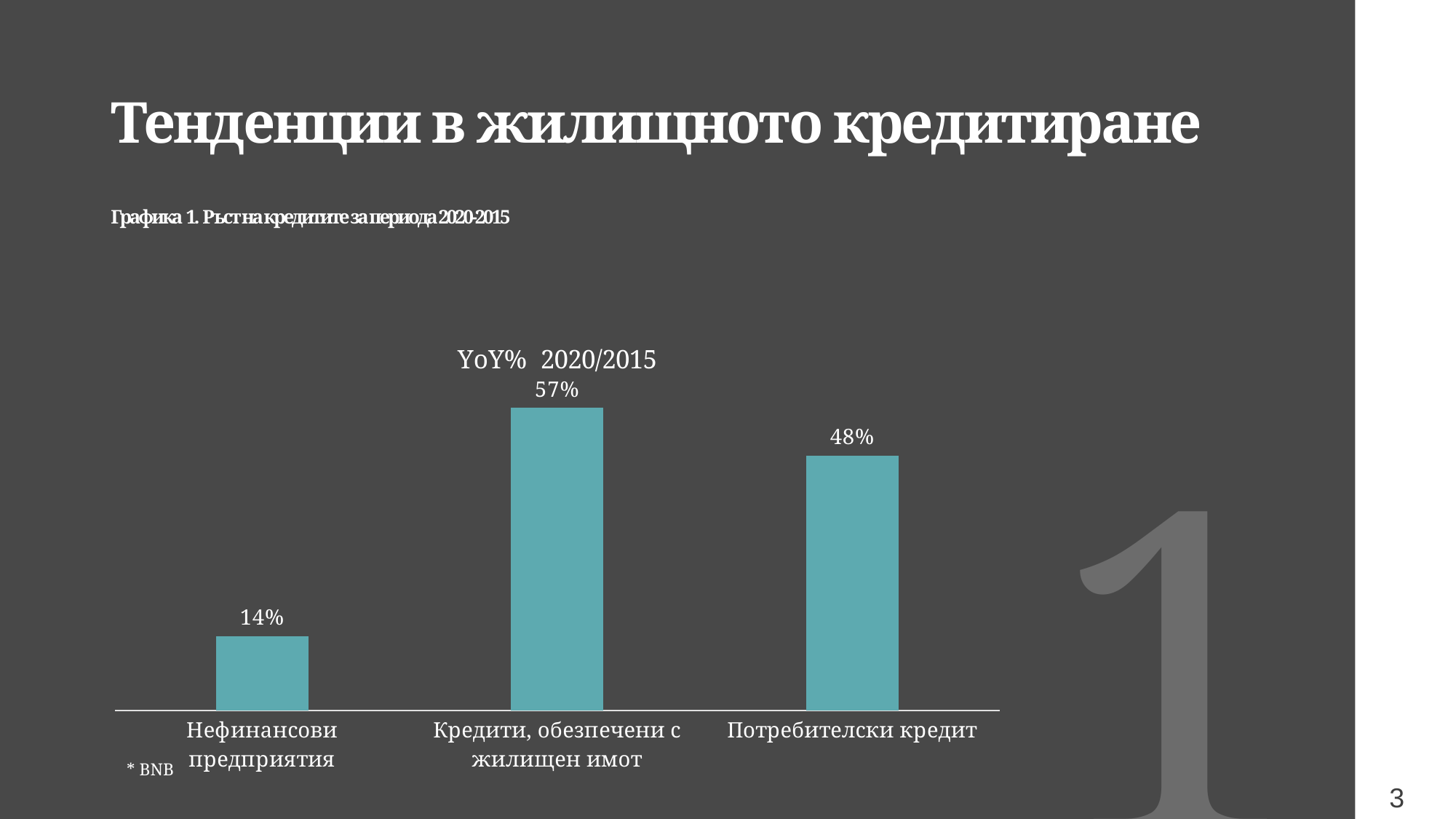
What is the value for Нефинансови предприятия? 14% What is the title of the chart? YoY% 2020/2015 What is the value for Потребителски кредит? 48% What is the difference between the values for Кредити, обезпечени с жилищен имот and Потребителски кредит? 9% What kind of chart is shown on the slide? Bar chart How many categories are shown in the chart? 3 Which category has the highest value? Кредити, обезпечени с жилищен имот What is the value for Кредити, обезпечени с жилищен имот? 57% What colour are the bars in the chart? Teal Which category has the lowest value? Нефинансови предприятия What is the difference between the values for Потребителски кредит and Нефинансови предприятия? 34% Which is larger, the value for Потребителски кредит or the value for Нефинансови предприятия? Потребителски кредит